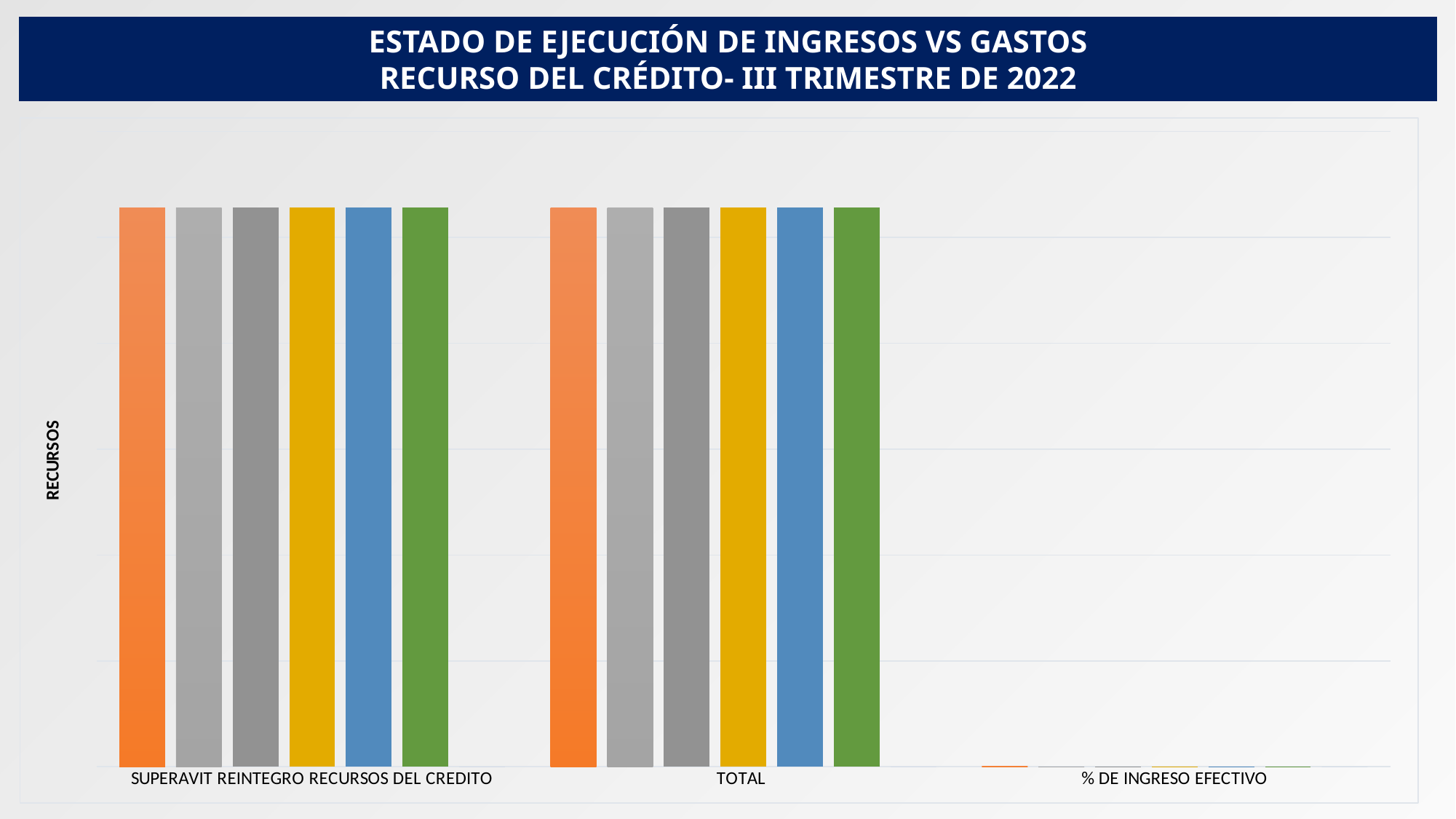
What is the title of the chart on the slide? ESTADO DE EJECUCIÓN DE INGRESOS VS GASTOS RECURSO DEL CRÉDITO- III TRIMESTRE DE 2022 Which category has the lowest bars in the chart? % DE INGRESO EFECTIVO How many bars are plotted for the TOTAL category? 6 Which category has larger bars, TOTAL or % DE INGRESO EFECTIVO? TOTAL What is the label on the vertical axis of the chart? RECURSOS Do the bar heights rise or fall from the first category to the last category along the x axis? fall What kind of chart is shown on the slide? bar chart How many categories are shown on the x axis of the chart? 3 Which category has larger bars, SUPERAVIT REINTEGRO RECURSOS DEL CREDITO or % DE INGRESO EFECTIVO? SUPERAVIT REINTEGRO RECURSOS DEL CREDITO